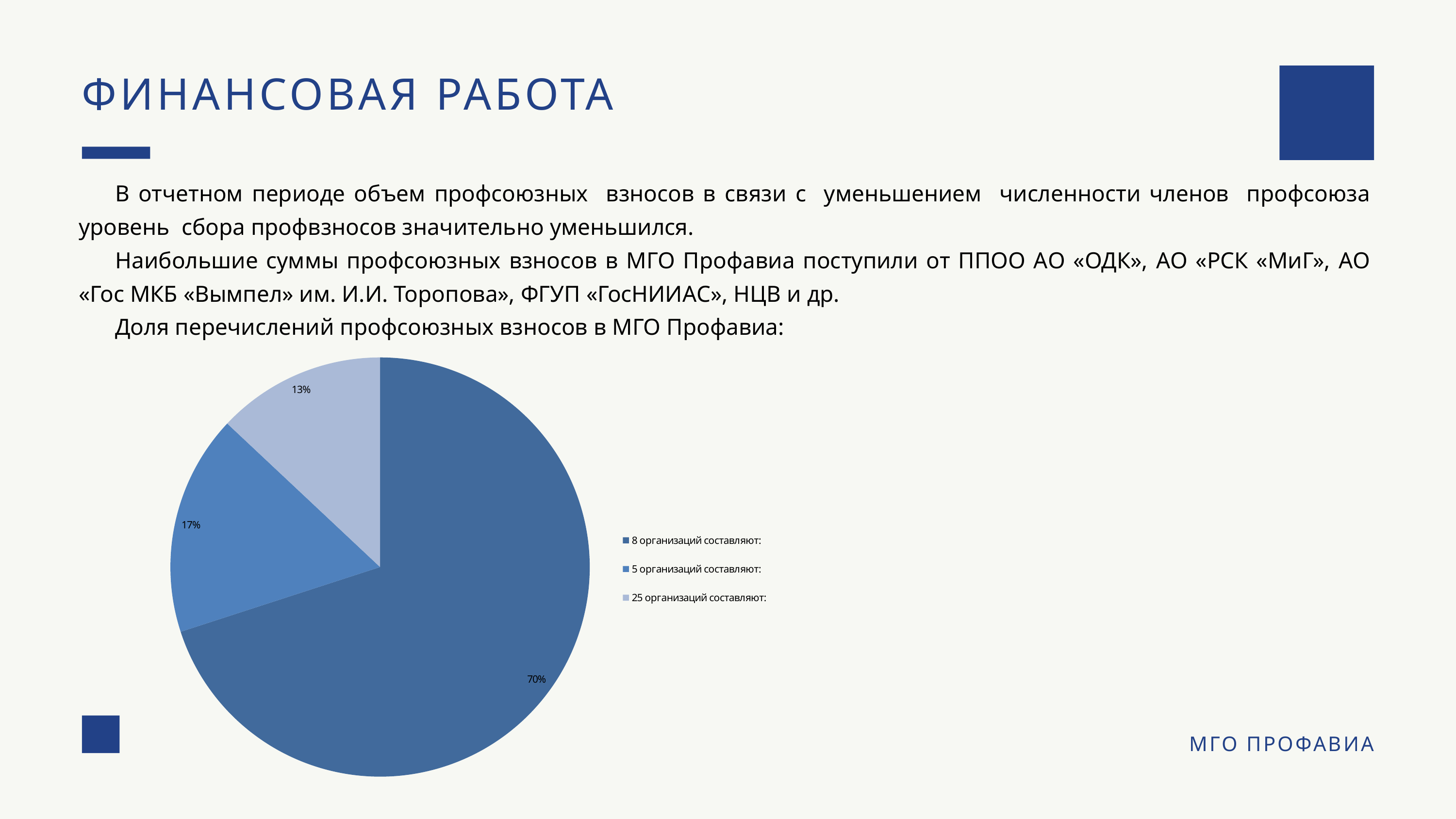
What is the difference in percentage points between the slice for "8 организаций составляют:" and the slice for "5 организаций составляют:"? 53 Which legend entry is shown in the lightest blue colour? 25 организаций составляют: Which slice is larger: "5 организаций составляют:" or "25 организаций составляют:"? 5 организаций составляют: What share of the pie does the slice for "25 организаций составляют:" have? 13% Which legend category has the smallest slice of the pie? 25 организаций составляют: Which legend category has the largest slice of the pie? 8 организаций составляют: How many entries does the legend of the pie chart list? 3 What share of the pie does the slice for "8 организаций составляют:" have? 70% How many slices does the pie chart have? 3 What is the difference in percentage points between the slice for "5 организаций составляют:" and the slice for "25 организаций составляют:"? 4 What kind of chart is shown on the slide? pie chart What share of the pie does the slice for "5 организаций составляют:" have? 17%